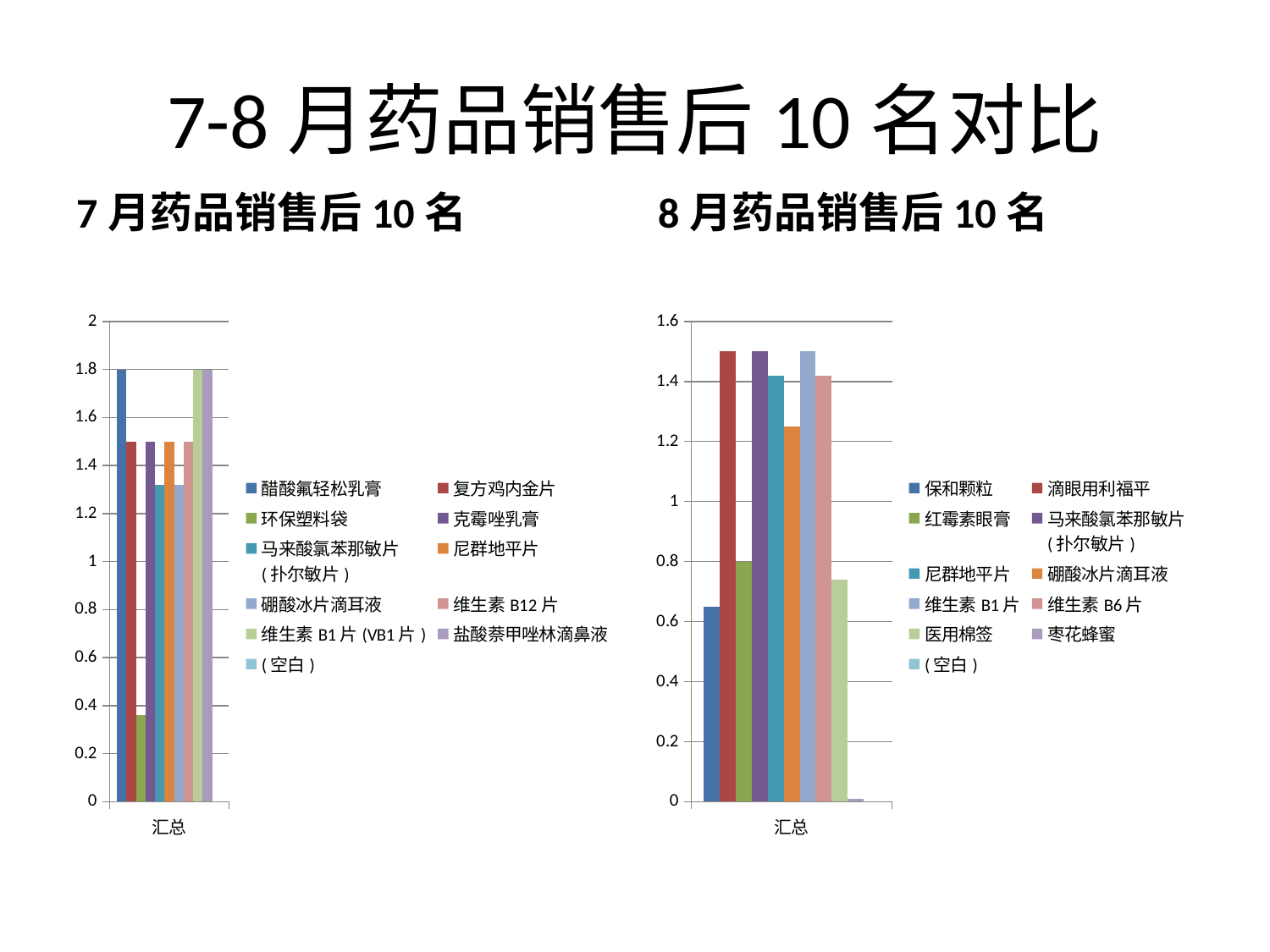
What kind of chart is the 7月药品销售后10名 chart on the left? bar chart What is the category label on the x axis of the 7月药品销售后10名 chart on the left? 汇总 In the 7月药品销售后10名 chart on the left, what is the value for 醋酸氟轻松乳膏? 1.8 How many series does the legend of the 8月药品销售后10名 chart on the right list? 11 In the 8月药品销售后10名 chart on the right, is the value for 硼酸冰片滴耳液 greater or less than 1.2? greater In the 7月药品销售后10名 chart on the left, which series has the lowest value? 环保塑料袋 In the 7月药品销售后10名 chart on the left, is the value for 环保塑料袋 greater or less than 0.4? less In the 8月药品销售后10名 chart on the right, what is the value for 红霉素眼膏? 0.8 In the 8月药品销售后10名 chart on the right, which is larger, 滴眼用利福平 or 红霉素眼膏? 滴眼用利福平 How many series does the legend of the 7月药品销售后10名 chart on the left list? 11 In the 8月药品销售后10名 chart on the right, which series has the lowest value? 枣花蜂蜜 In the 8月药品销售后10名 chart on the right, is the value for 保和颗粒 greater or less than 0.6? greater